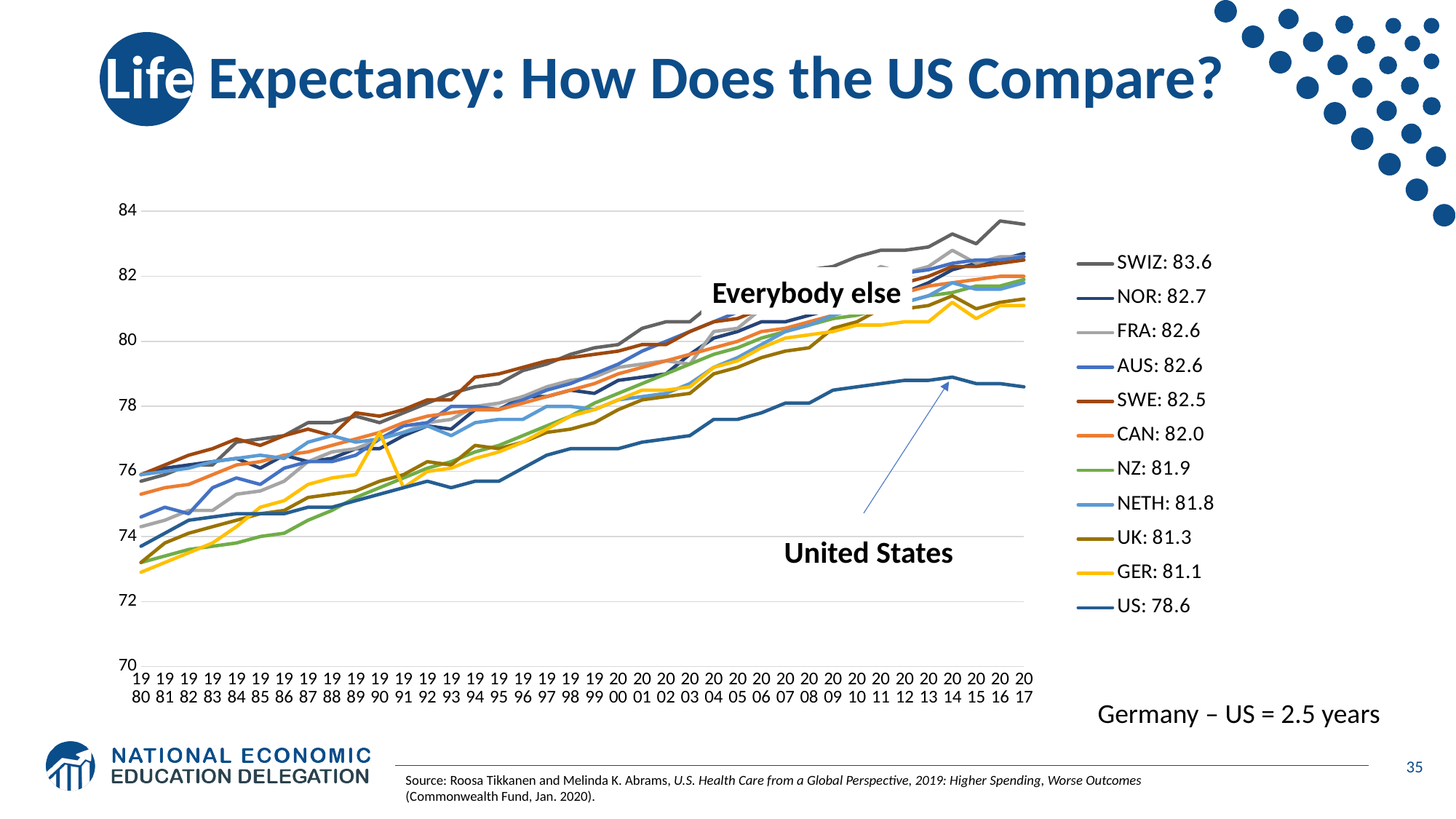
What is the life expectancy value shown for the US in the legend? 78.6 Which has a higher legend value, NOR or CAN? NOR Which country has the lowest life expectancy value in the legend? US Which country has the highest life expectancy value in the legend? SWIZ Do the life expectancy lines generally rise or fall from 1980 to 2017? Rise How many series does the legend list? 11 What value does the legend give for GER? 81.1 What is the difference between the SWIZ value and the US value shown in the legend? 5.0 What type of chart is shown on the slide? Line chart Is the US value in 2000 greater or less than 78? less According to the text below the legend, what is the gap between Germany and the US? 2.5 years What is the 2017 life expectancy value shown for SWIZ in the legend? 83.6